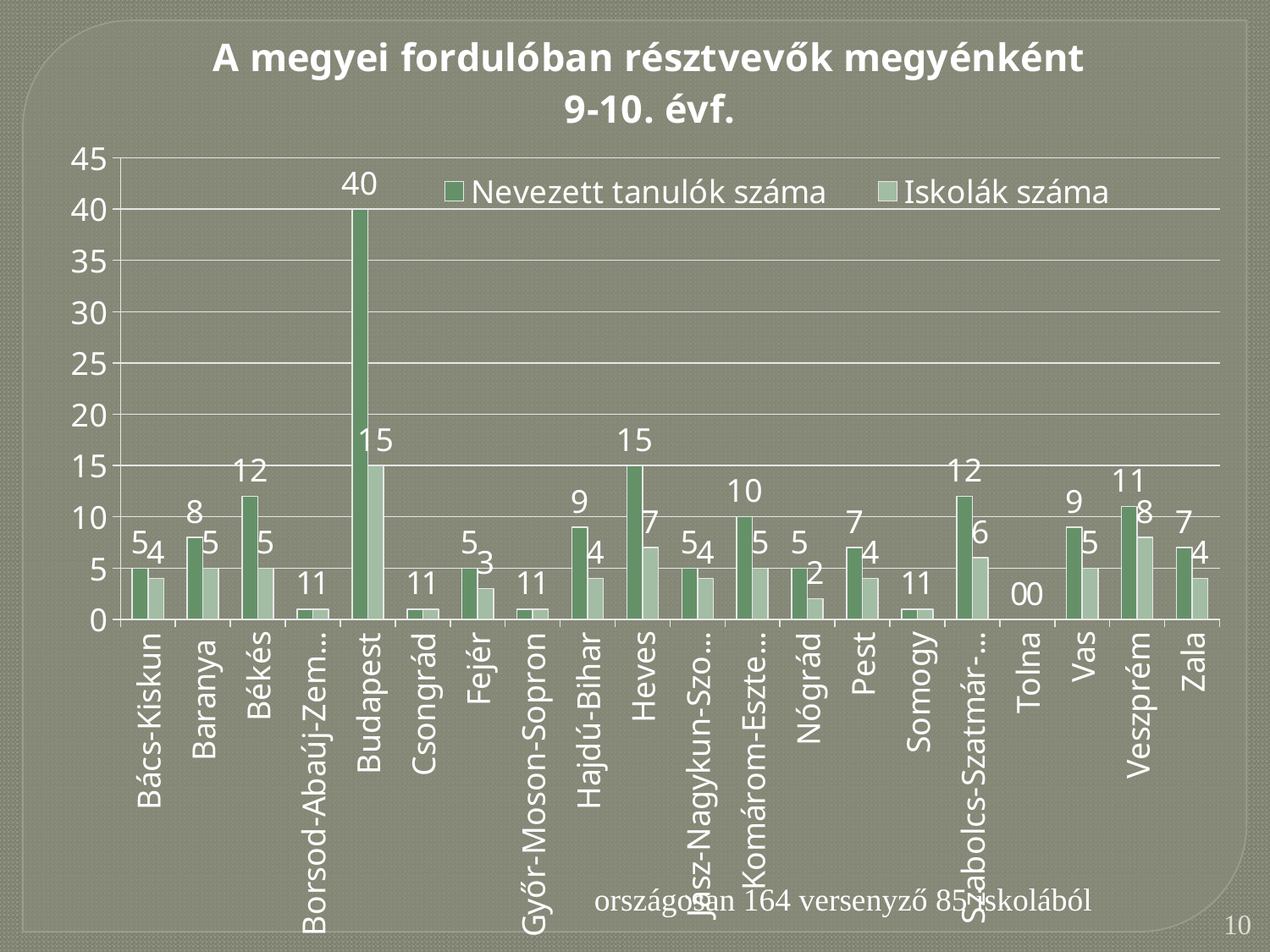
Is the value of Nevezett tanulók száma for Budapest greater or less than 35? greater Which category has the highest value for Nevezett tanulók száma? Budapest What is the value of Iskolák száma for Veszprém? 8 How many series does the legend list? 2 Which is larger: Nevezett tanulók száma for Heves or for Komárom-Eszte…? Heves What is the difference in Nevezett tanulók száma between Békés and Baranya? 4 What kind of chart is shown on the slide? bar chart What is the value of Nevezett tanulók száma for Heves? 15 Which category has the lowest value for Iskolák száma? Tolna What is the difference between Nevezett tanulók száma and Iskolák száma for Budapest? 25 How many categories are shown on the x axis? 20 What is the value of Nevezett tanulók száma for Budapest? 40